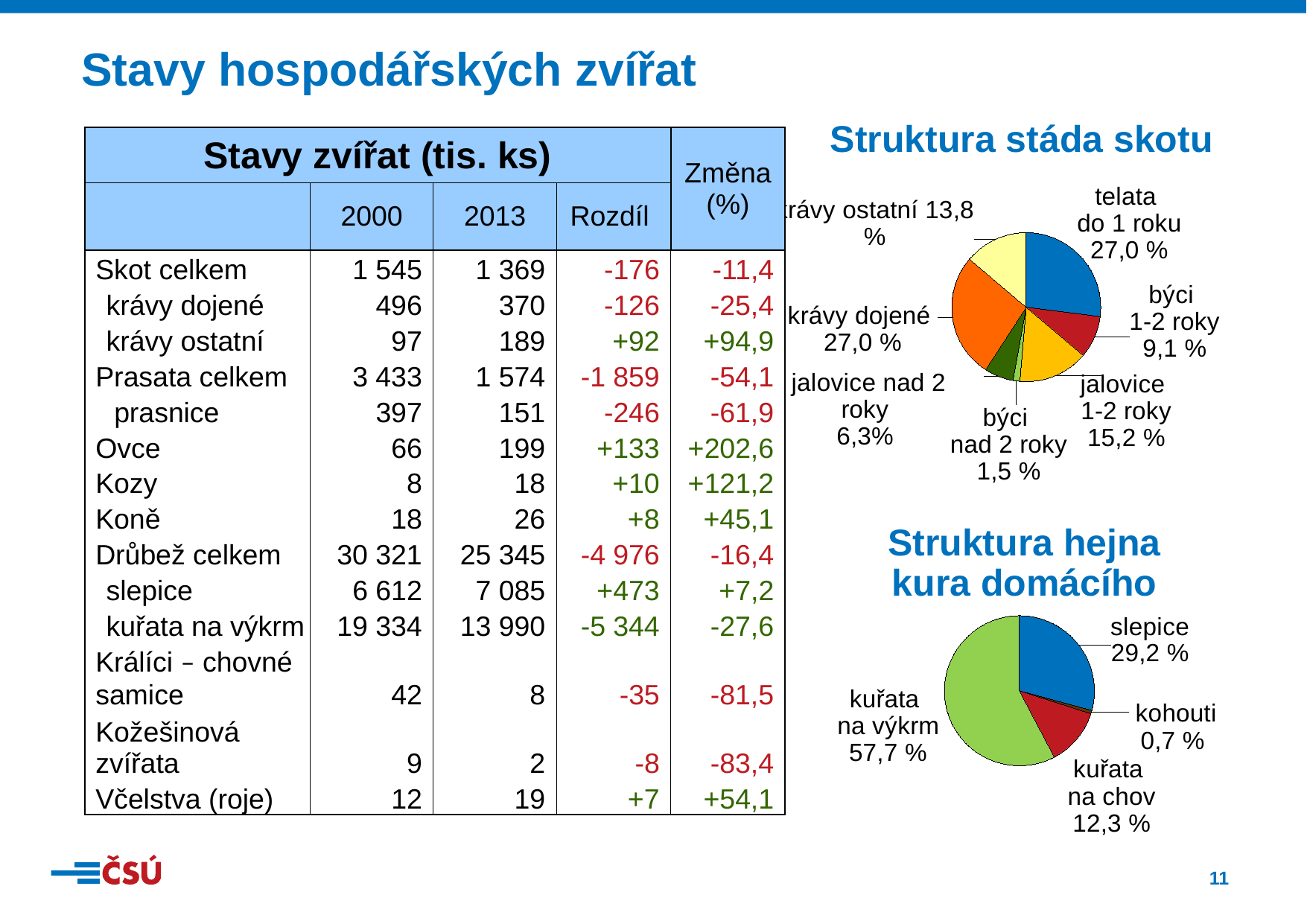
What kind of chart is 'Struktura hejna kura domácího'? pie chart In the 'Struktura hejna kura domácího' chart, what is the difference in percentage points between 'slepice' and 'kuřata na chov'? 16,9 In the 'Struktura stáda skotu' chart, what share is shown for 'telata do 1 roku'? 27,0 % In the 'Struktura hejna kura domácího' chart, how many slices does the pie have? 4 In the 'Struktura stáda skotu' chart, what share is shown for 'jalovice 1-2 roky'? 15,2 % In the 'Struktura stáda skotu' chart, which is larger: 'krávy ostatní' or 'býci 1-2 roky'? krávy ostatní In the 'Struktura stáda skotu' chart, what is the difference in percentage points between 'krávy dojené' and 'krávy ostatní'? 13,2 In the 'Struktura hejna kura domácího' chart, which category has the smallest share? kohouti In the 'Struktura hejna kura domácího' chart, which category has the largest share? kuřata na výkrm In the 'Struktura stáda skotu' chart, how many slices does the pie have? 7 In the 'Struktura stáda skotu' chart, which category has the smallest share? býci nad 2 roky In the 'Struktura hejna kura domácího' chart, what share is shown for 'kuřata na výkrm'? 57,7 %